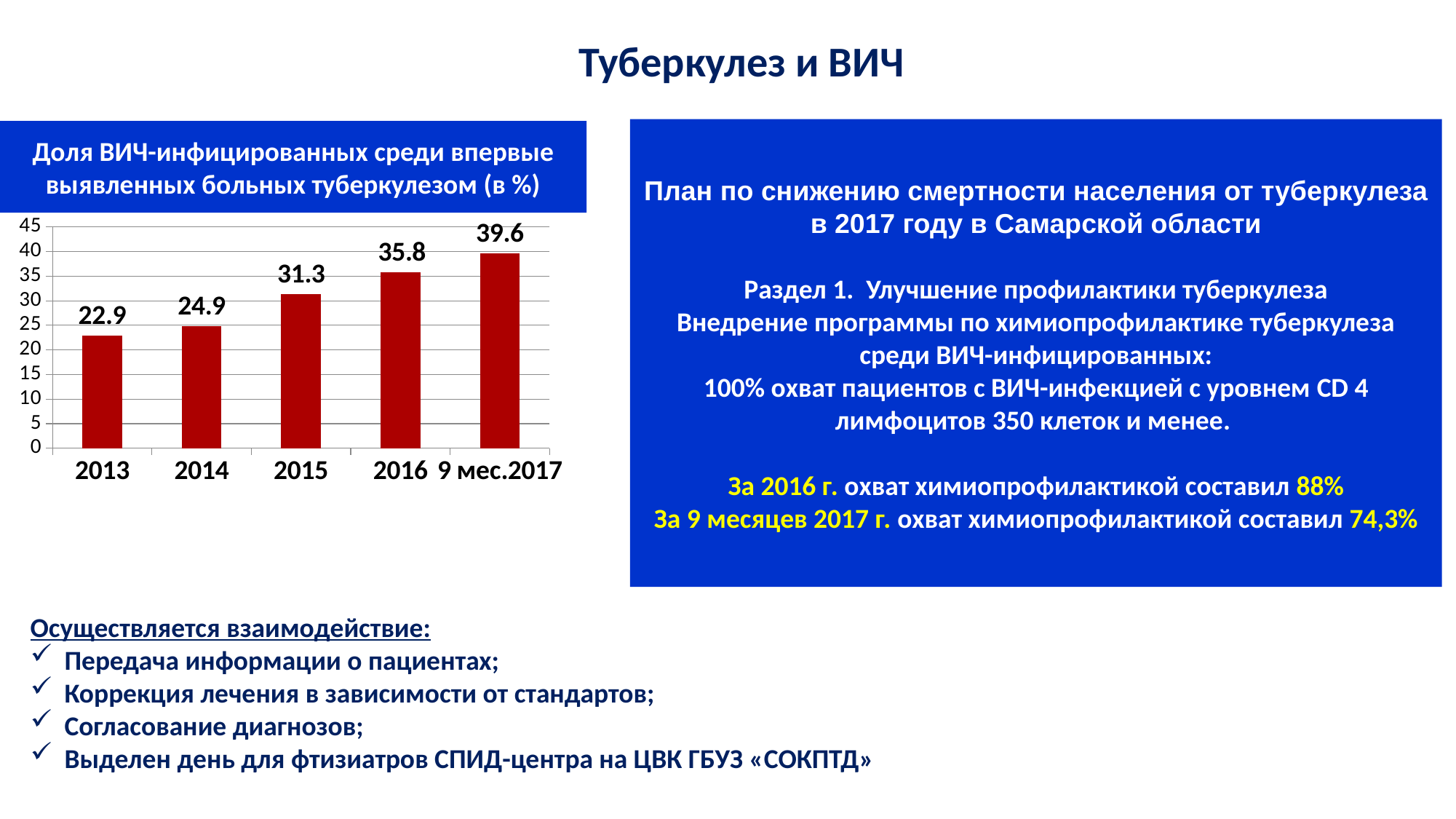
What is the value for 2013? 22.9 Which category has the lowest value? 2013 What is the difference between the values for 9 мес.2017 and 2013? 16.7 What kind of chart is shown on the slide? bar chart What is the value for 9 мес.2017? 39.6 Do the values rise or fall from 2013 to 9 мес.2017? rise What is the value for 2015? 31.3 Is the value for 2015 greater or less than 30? greater How many categories are shown on the x axis? 5 Which category has the highest value? 9 мес.2017 What is the difference between the values for 2016 and 2015? 4.5 Which is larger, the value for 2014 or the value for 2016? 2016